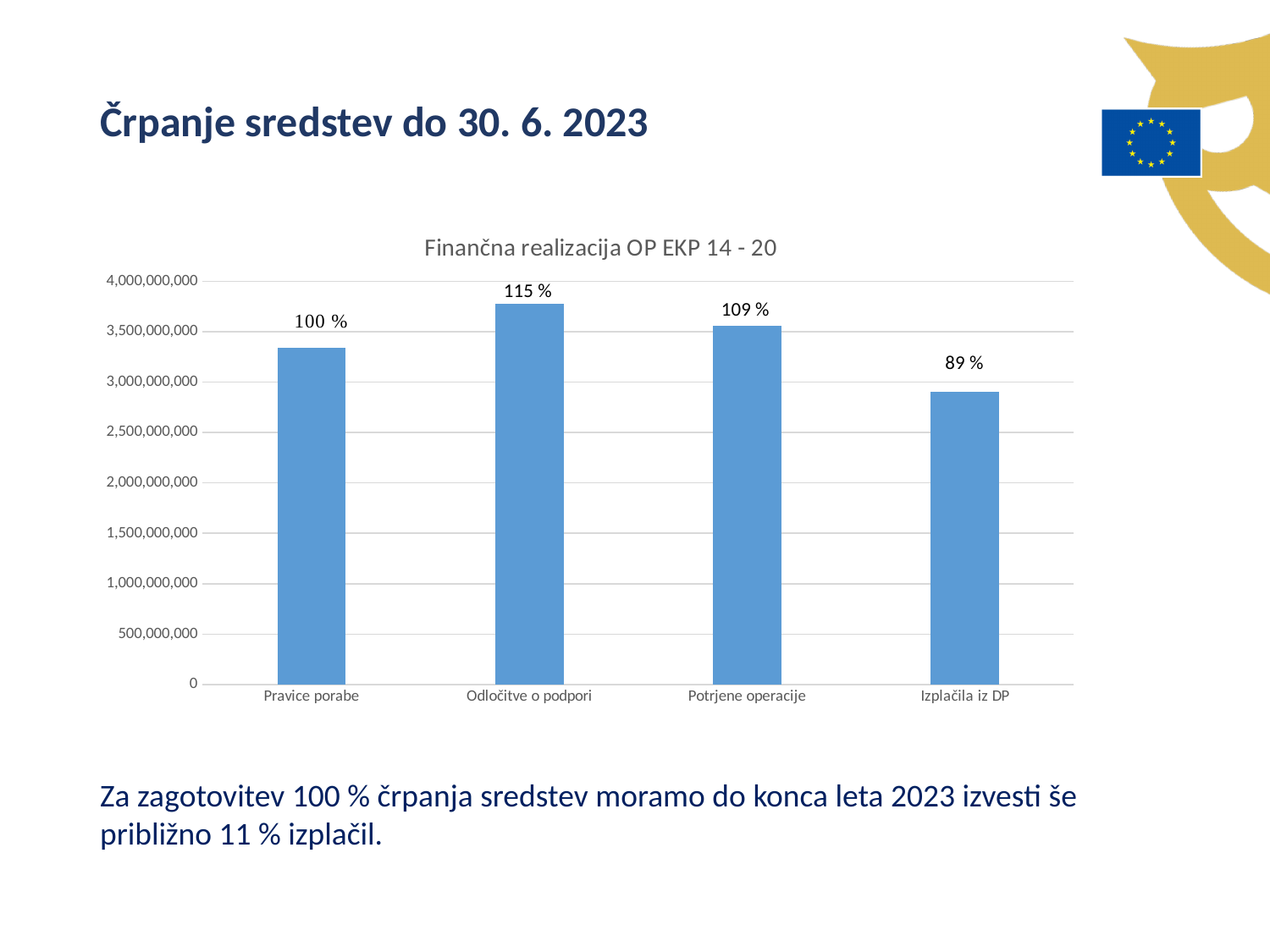
Which category has the highest bar? Odločitve o podpori How many categories are shown on the x axis? 4 Which bar is taller, Potrjene operacije or Izplačila iz DP? Potrjene operacije What is the difference in percentage points between the labels for Odločitve o podpori and Izplačila iz DP? 26 % What label is shown above the bar for Odločitve o podpori? 115 % Is the value for Odločitve o podpori greater or less than 3,500,000,000? greater Is the value for Izplačila iz DP greater or less than 3,000,000,000? less What label is shown above the bar for Potrjene operacije? 109 % What label is shown above the bar for Pravice porabe? 100 % What is the title of the chart? Finančna realizacija OP EKP 14 - 20 Which category has the lowest bar? Izplačila iz DP What label is shown above the bar for Izplačila iz DP? 89 %